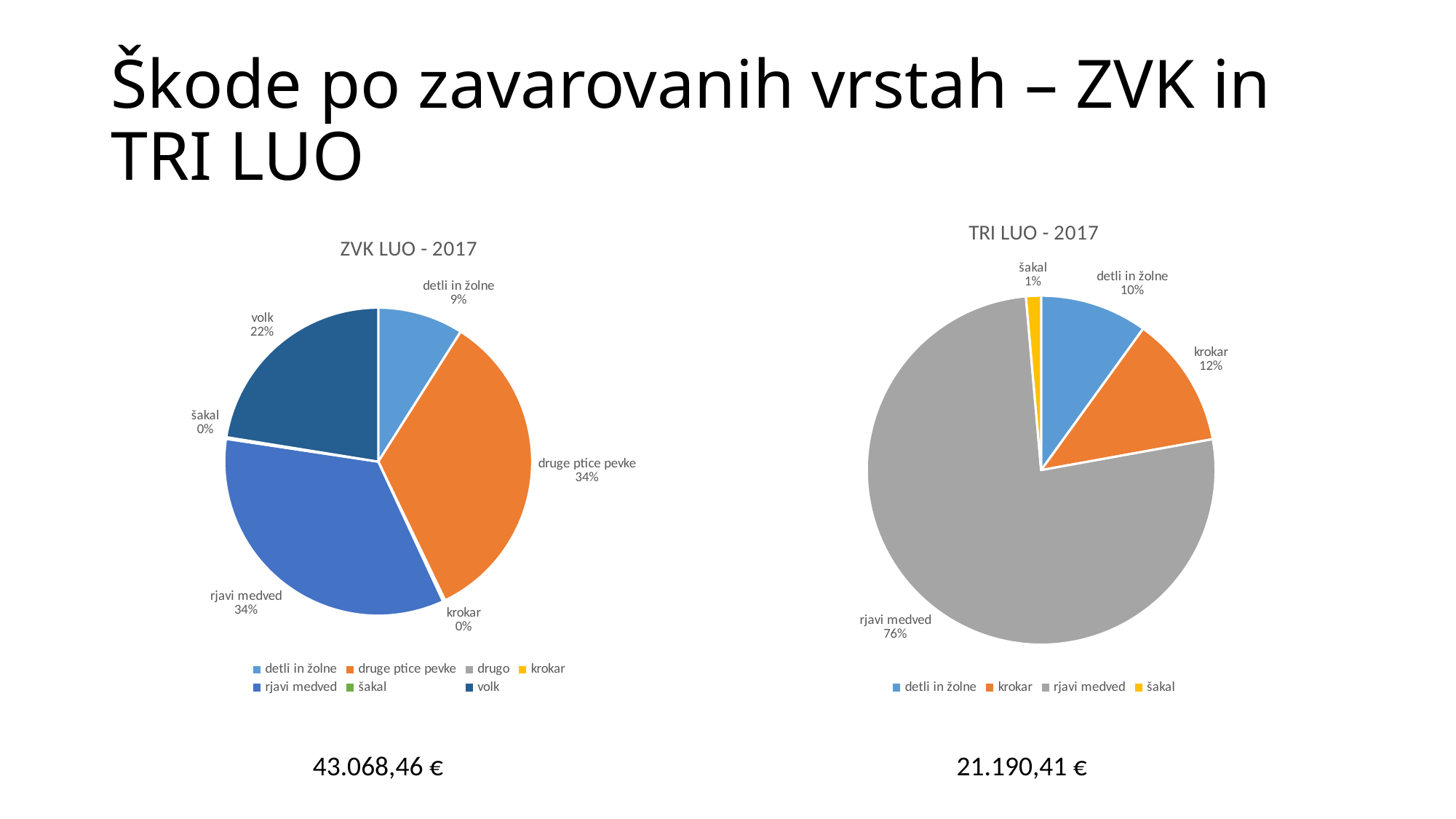
In the TRI LUO - 2017 chart, which category has the largest share? rjavi medved In the TRI LUO - 2017 chart, what is the difference between the share for krokar and the share for detli in žolne? 2% What kind of chart is the TRI LUO - 2017 chart? pie chart In the ZVK LUO - 2017 chart, what share does volk have? 22% In the TRI LUO - 2017 chart, which category has the smallest share? šakal In the ZVK LUO - 2017 chart, which is larger, the share for volk or the share for detli in žolne? volk In the ZVK LUO - 2017 chart, what share does detli in žolne have? 9% How many categories are shown in the TRI LUO - 2017 chart? 4 In the ZVK LUO - 2017 chart, what is the difference between the share for rjavi medved and the share for volk? 12% In the ZVK LUO - 2017 chart, what share does druge ptice pevke have? 34% How many entries does the legend of the ZVK LUO - 2017 chart list? 7